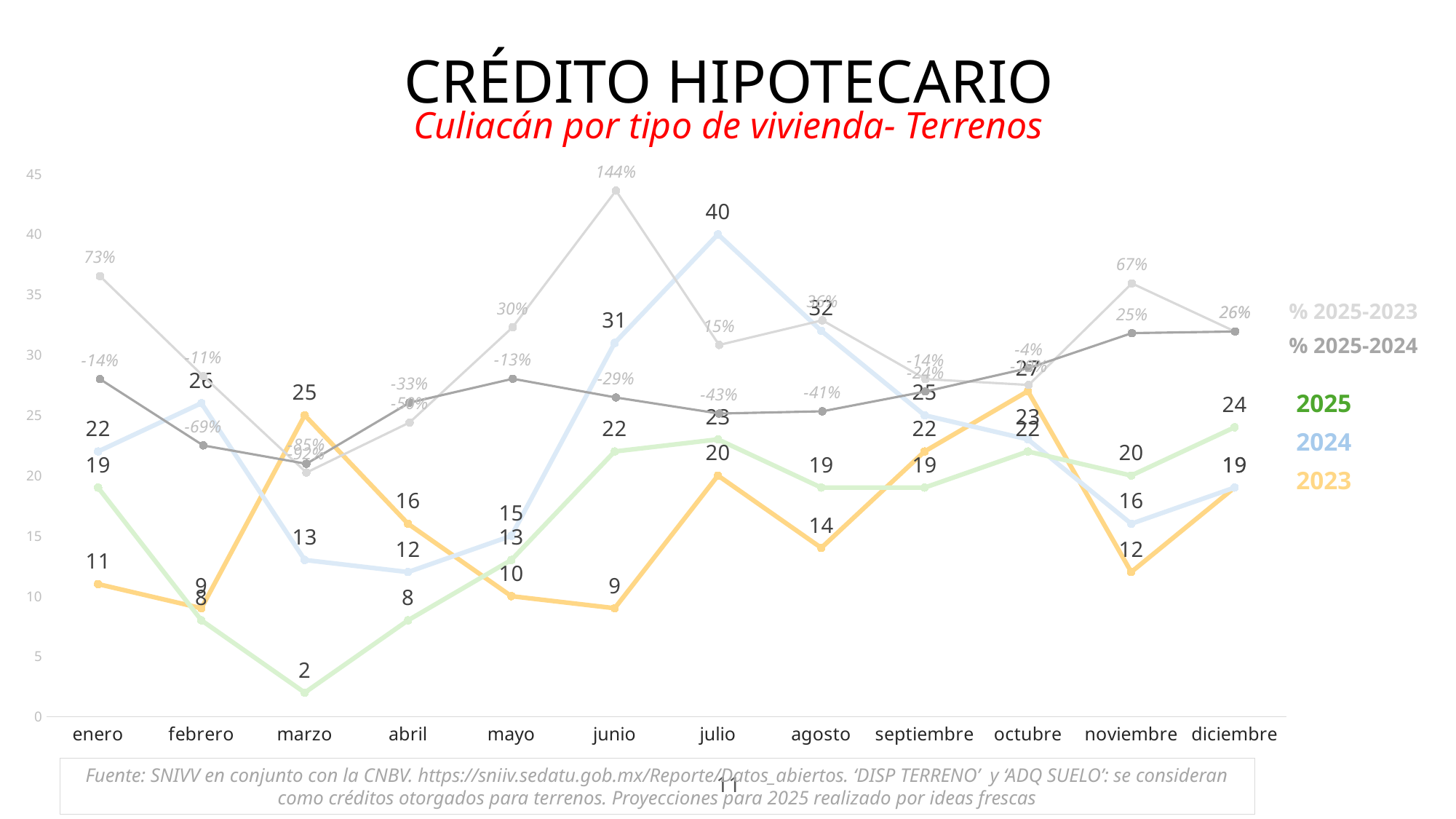
In marzo, which series has the larger value, 2023 or 2024? 2023 What is the value for 2024 in julio? 40 How many months are shown on the x axis? 12 What is the value for 2025 in diciembre? 24 What is the value for 2023 in octubre? 27 What is the value for 2025 in marzo? 2 What kind of chart is shown on the slide? line chart In which month does the 2024 series reach its highest value? julio What is the difference between the 2024 and 2025 values in julio? 17 In which month does the 2025 series have its lowest value? marzo Does the 2024 series rise or fall from abril to julio? rise How many series does the legend list? 5